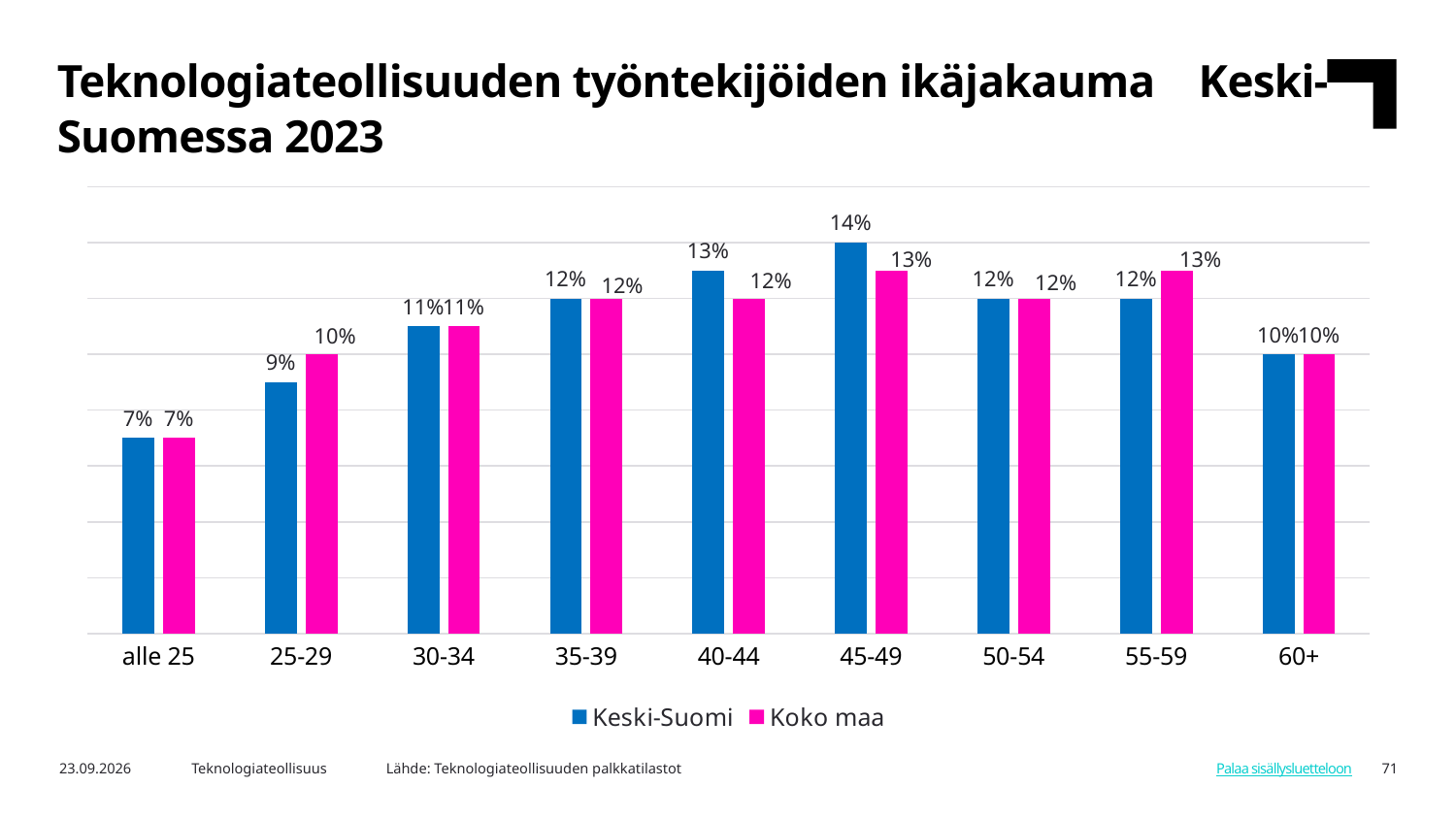
What is the difference between the Keski-Suomi and Koko maa values in the 25-29 age group? 1% What is the value for Keski-Suomi in the 60+ age group? 10% Which age group has the highest value for Keski-Suomi? 45-49 How many age categories are shown on the x axis? 9 What kind of chart is shown on the slide? bar chart Which series is shown in pink? Koko maa What is the value for Keski-Suomi in the 45-49 age group? 14% In the 55-59 age group, which series has the larger value, Keski-Suomi or Koko maa? Koko maa Which age group has the lowest value for Koko maa? alle 25 How many series does the legend list? 2 Do the Keski-Suomi values rise or fall from the alle 25 group to the 45-49 group? rise What is the value for Koko maa in the 25-29 age group? 10%